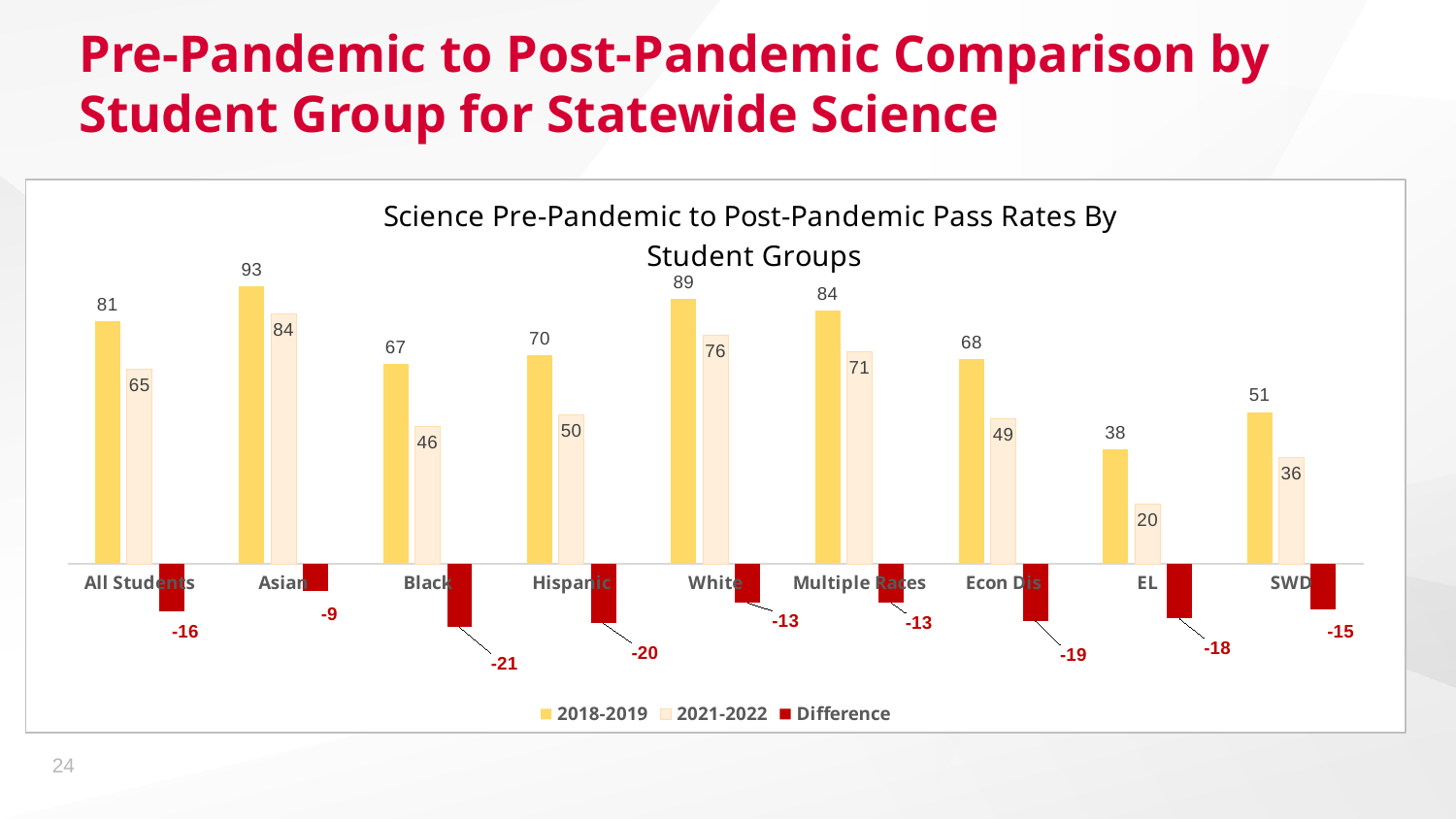
What is the 2021-2022 pass rate for EL students? 20 What is the title of the chart? Science Pre-Pandemic to Post-Pandemic Pass Rates By Student Groups Which student group has the highest 2018-2019 pass rate? Asian How many series does the legend list? 3 Which student group has the lowest 2021-2022 pass rate? EL What kind of chart is shown on the slide? Bar chart What is the 2018-2019 pass rate for Black students? 67 What is the Difference value for Hispanic students? -20 Which student group has the smallest decline (Difference closest to zero)? Asian How many student groups are shown on the x axis? 9 What is the difference between the 2018-2019 and 2021-2022 pass rates for White students? 13 Which is larger, the 2021-2022 pass rate for Econ Dis or for SWD? Econ Dis